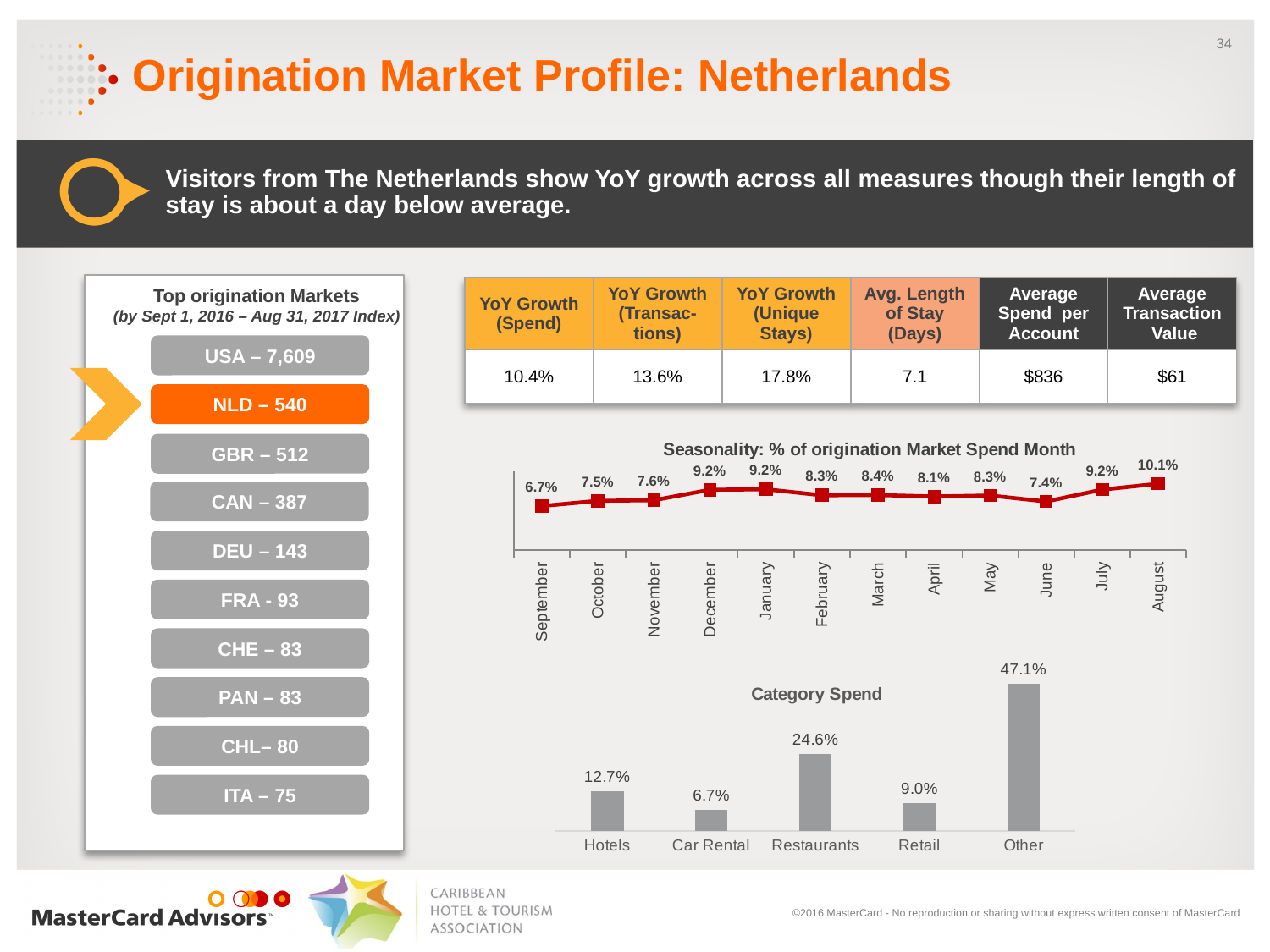
In the Category Spend chart, which category has the highest value? Other In the Category Spend chart, which category has the lowest value? Car Rental What kind of chart is the Seasonality chart? Line chart What kind of chart is the Category Spend chart? Bar chart In the Seasonality chart, which month has the lowest value? September In the Seasonality chart, which month has the highest value? August In the Seasonality chart, what is the value for August? 10.1% In the Seasonality chart, how many months are plotted? 12 In the Category Spend chart, what is the value for Restaurants? 24.6% In the Category Spend chart, which is larger, Hotels or Retail? Hotels In the Seasonality chart, what is the value for September? 6.7% In the Seasonality chart, what is the difference between the values for August and June? 2.7%